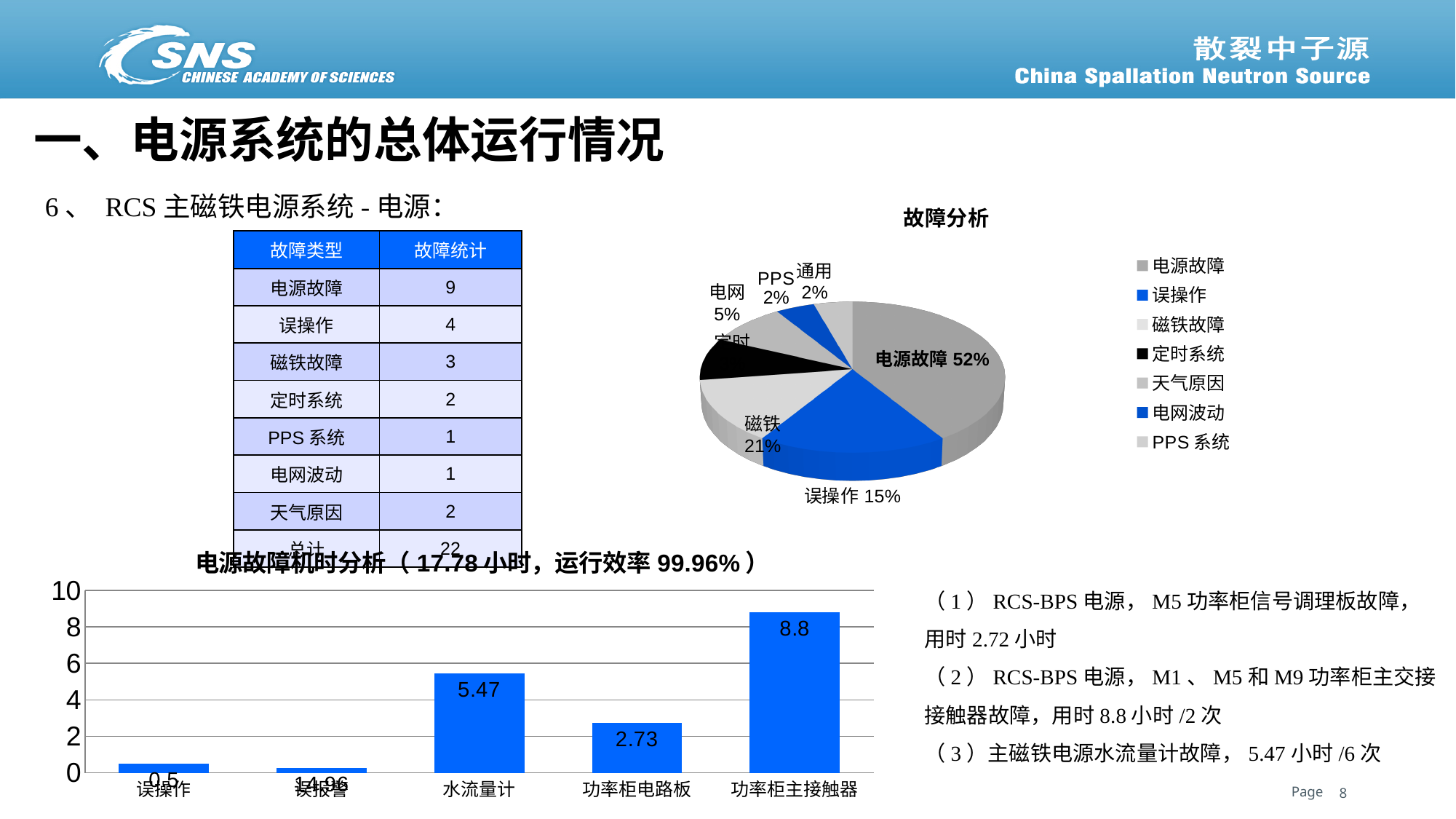
In the bar chart 电源故障机时分析, what is the difference between the values for 功率柜主接触器 and 水流量计? 3.33 In the bar chart 电源故障机时分析, what is the value for 功率柜电路板? 2.73 What kind of chart is the chart titled 电源故障机时分析? bar chart In the pie chart 故障分析, which slice is the largest? 电源故障 In the bar chart 电源故障机时分析, which is larger, the value for 水流量计 or the value for 功率柜电路板? 水流量计 In the bar chart 电源故障机时分析, what is the value for 功率柜主接触器? 8.8 In the bar chart 电源故障机时分析, which category has the highest value? 功率柜主接触器 In the bar chart 电源故障机时分析, what is the value for 水流量计? 5.47 In the pie chart 故障分析, what share does 电源故障 have? 52% How many categories are shown in the bar chart 电源故障机时分析? 5 In the pie chart 故障分析, what share does 误操作 have? 15% How many entries does the legend of the pie chart 故障分析 list? 7